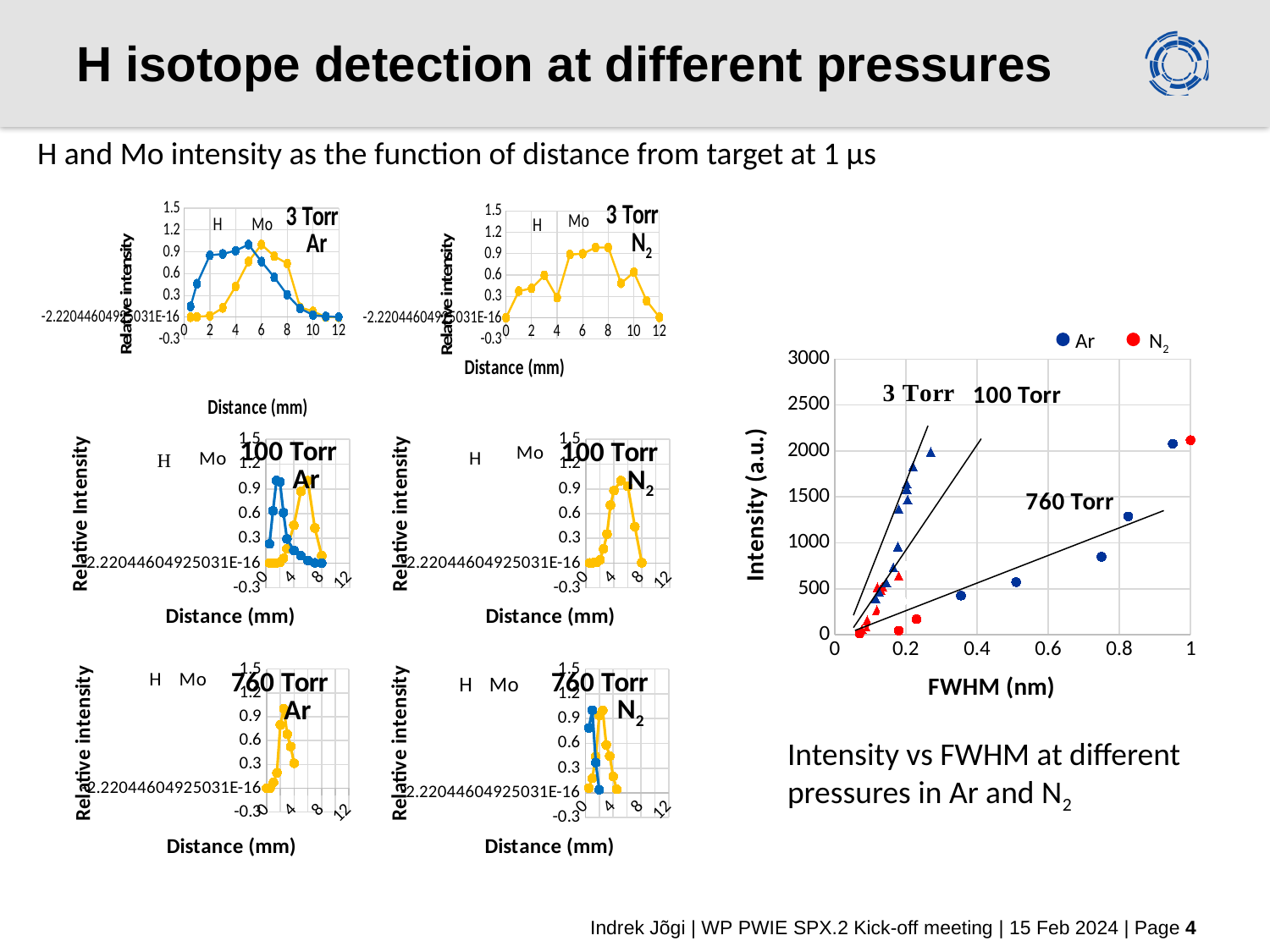
In the 3 Torr Ar chart, which series has the higher value at a distance of 2 mm, H or Mo? H What kind of chart is the 3 Torr Ar chart at the top left? line chart In the 760 Torr Ar chart, is the peak value of the Mo series greater or less than 0.6? greater How many series are plotted in the 3 Torr Ar chart? 2 How many series does the legend of the Intensity vs FWHM chart list? 2 In the Intensity vs FWHM chart, is the Ar point at about 0.5 nm FWHM greater or less than 1000 in intensity? less In the Intensity vs FWHM chart, is the highest N2 intensity greater or less than 1500? greater In the 3 Torr Ar chart, does the H series rise or fall as distance increases from 6 mm to 12 mm? fall What are the two legend entries of the Intensity vs FWHM chart? Ar and N2 What kind of chart is the Intensity vs FWHM chart on the right of the slide? scatter chart In the Intensity vs FWHM chart, which of the three labelled pressure lines (3 Torr, 100 Torr, 760 Torr) has the shallowest slope? 760 Torr What is the x-axis label of the Intensity vs FWHM chart? FWHM (nm)